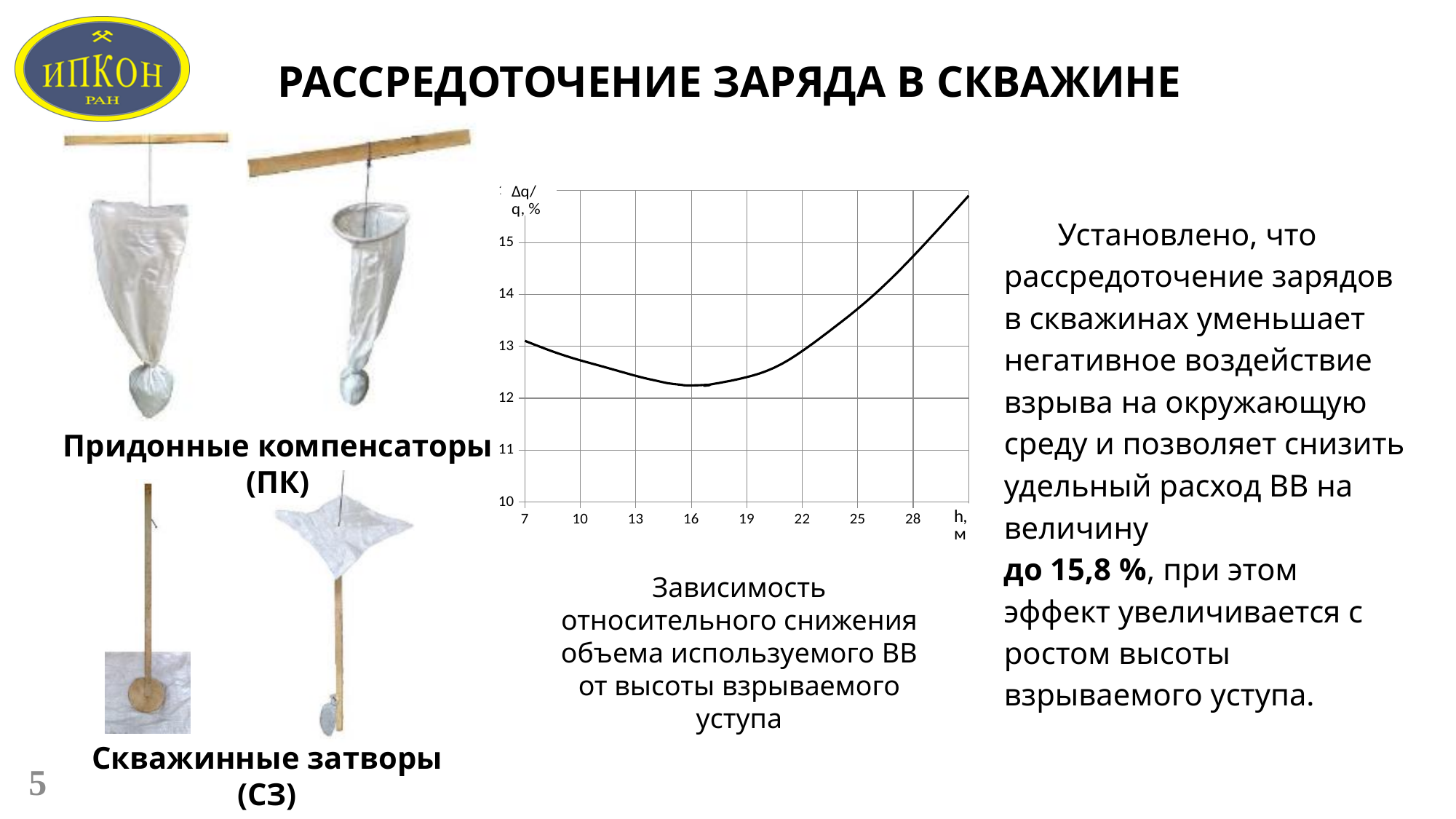
At which value of h on the x axis does the curve reach its lowest point? 16 Is the value of Δq/q at h = 7 greater or less than 12? greater How many tick labels are shown on the x axis of the chart? 8 Is the value of Δq/q at h = 28 greater or less than 14? greater Does the curve rise or fall as h increases from 16 to 28 m? rises What kind of chart is shown on the slide? line chart Is the value of Δq/q at h = 10 greater or less than 13? less Does the curve rise or fall as h increases from 7 to 16 m? falls What is the label of the vertical axis of the chart? Δq/q, %